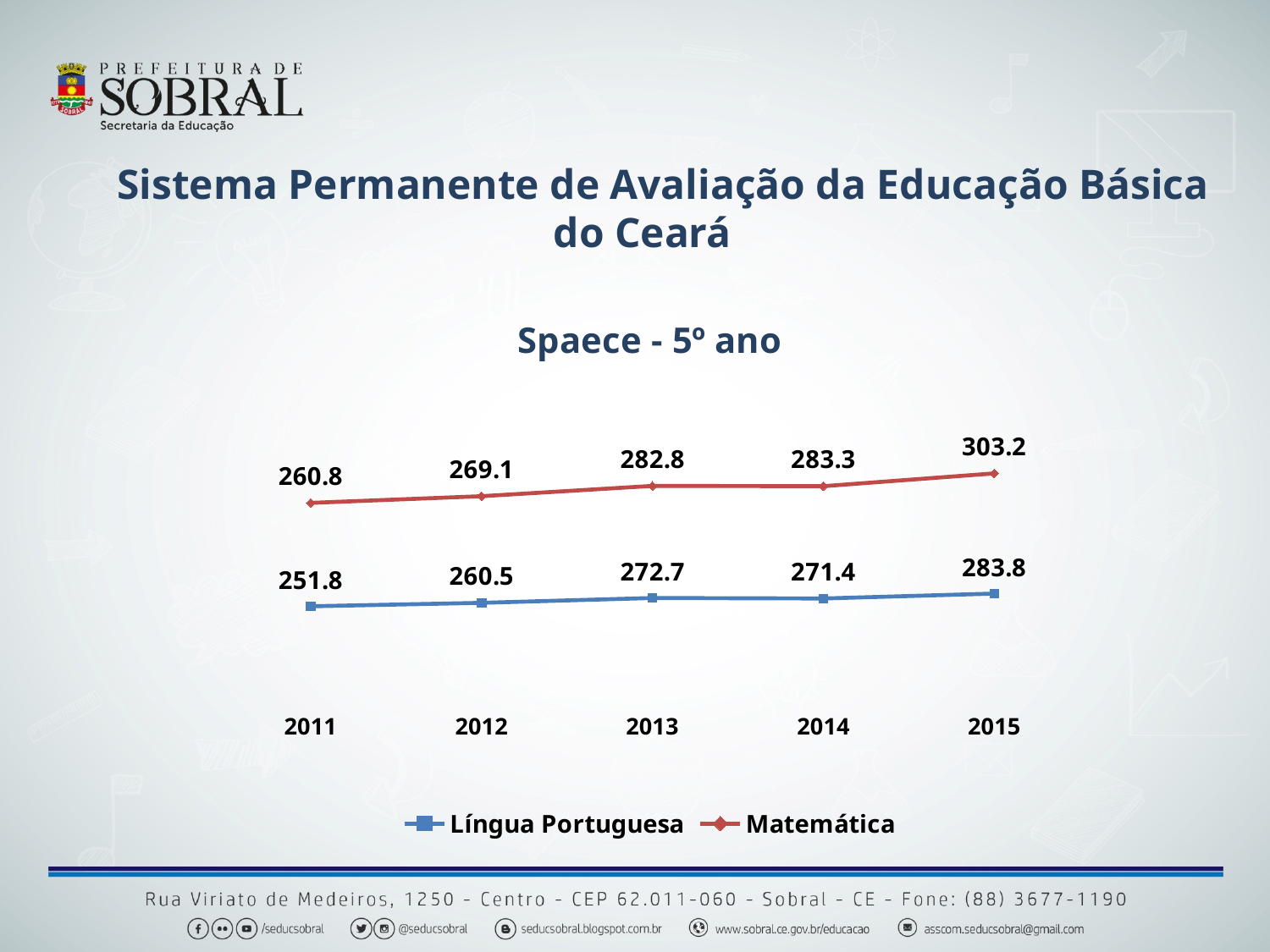
What kind of chart is shown? Line chart In which year is the Matemática value highest? 2015 In which year is the Língua Portuguesa value lowest? 2011 What is the title of the chart? Spaece - 5º ano Does the Matemática series generally rise or fall from 2011 to 2015? Rise What is the Língua Portuguesa value for 2013? 272.7 How many series does the legend list? 2 What is the difference between the Matemática and Língua Portuguesa values in 2015? 19.4 Which is larger in 2014: the Matemática value or the Língua Portuguesa value? Matemática What is the Matemática value for 2015? 303.2 What is the Língua Portuguesa value for 2011? 251.8 How many years are shown on the x axis? 5